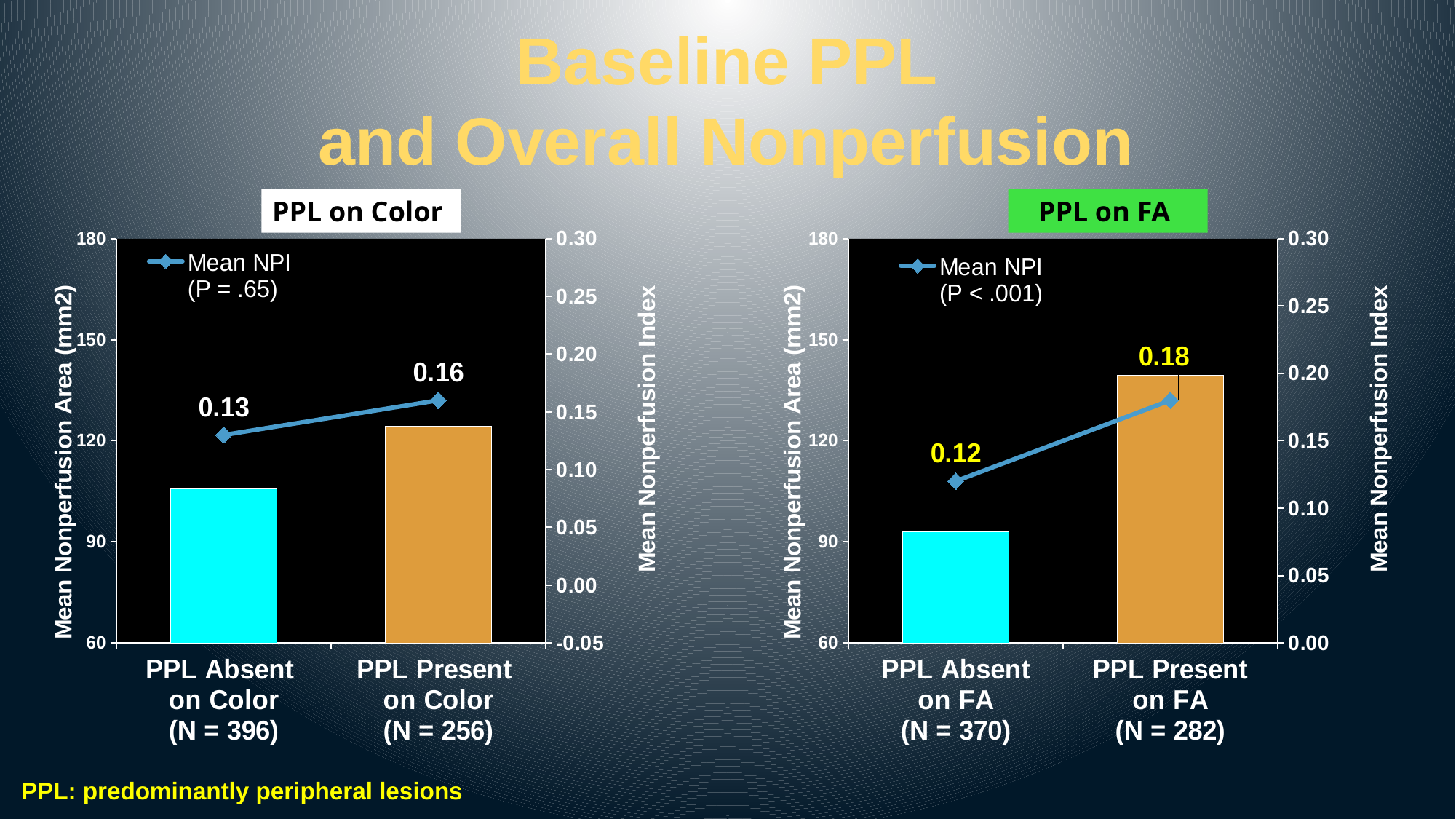
How many categories are shown on the x axis of the PPL on FA chart? 2 In the PPL on FA chart, what is the difference in Mean NPI between PPL Present on FA and PPL Absent on FA? 0.06 In the PPL on Color chart, does the Mean NPI line rise or fall from PPL Absent on Color to PPL Present on Color? rise In the PPL on FA chart, is the Mean Nonperfusion Area bar for PPL Present on FA greater or less than 120 mm2? greater In the PPL on FA chart, what is the Mean NPI for PPL Absent on FA? 0.12 In the PPL on Color chart, is the Mean Nonperfusion Area bar for PPL Absent on Color greater or less than 120 mm2? less In the PPL on FA chart, which category has the higher Mean Nonperfusion Area bar? PPL Present on FA In the PPL on Color chart, what is the Mean NPI for PPL Absent on Color? 0.13 In the PPL on FA chart, what is the Mean NPI for PPL Present on FA? 0.18 In the PPL on Color chart, what is the Mean NPI for PPL Present on Color? 0.16 In the PPL on Color chart, what is the difference in Mean NPI between PPL Present on Color and PPL Absent on Color? 0.03 In the PPL on Color chart, what P value is shown next to the Mean NPI legend entry? P = .65